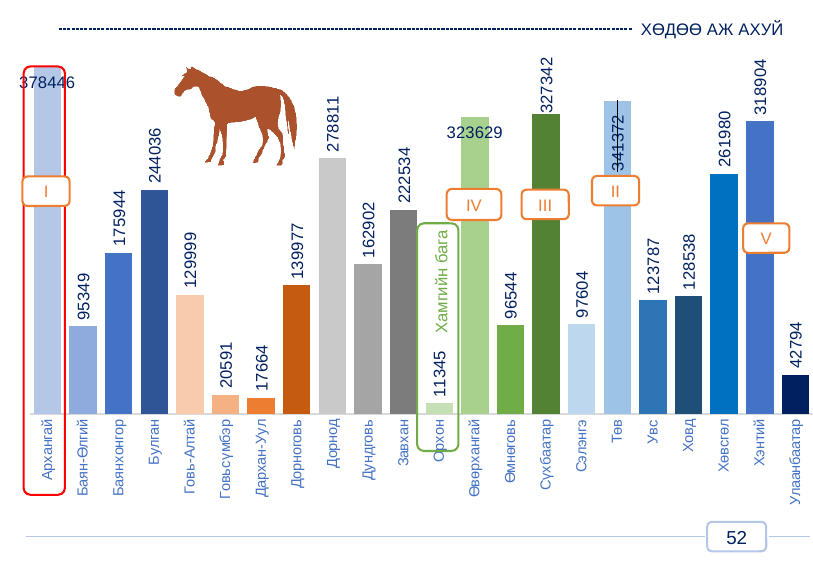
What is the value for Орхон? 11345 How many categories are shown on the x axis? 22 Which category is highlighted with the red box? Архангай Which category has the lowest value? Орхон Which category has the highest value? Архангай What is the value for Архангай? 378446 Which is larger, the value for Хэнтий or the value for Хөвсгөл? Хэнтий What kind of chart is shown on the slide? bar chart Which category is marked with the label "II"? Төв What is the value for Сүхбаатар? 327342 What is the value for Улаанбаатар? 42794 What is the difference between the values for Төв and Өвөрхангай? 17743